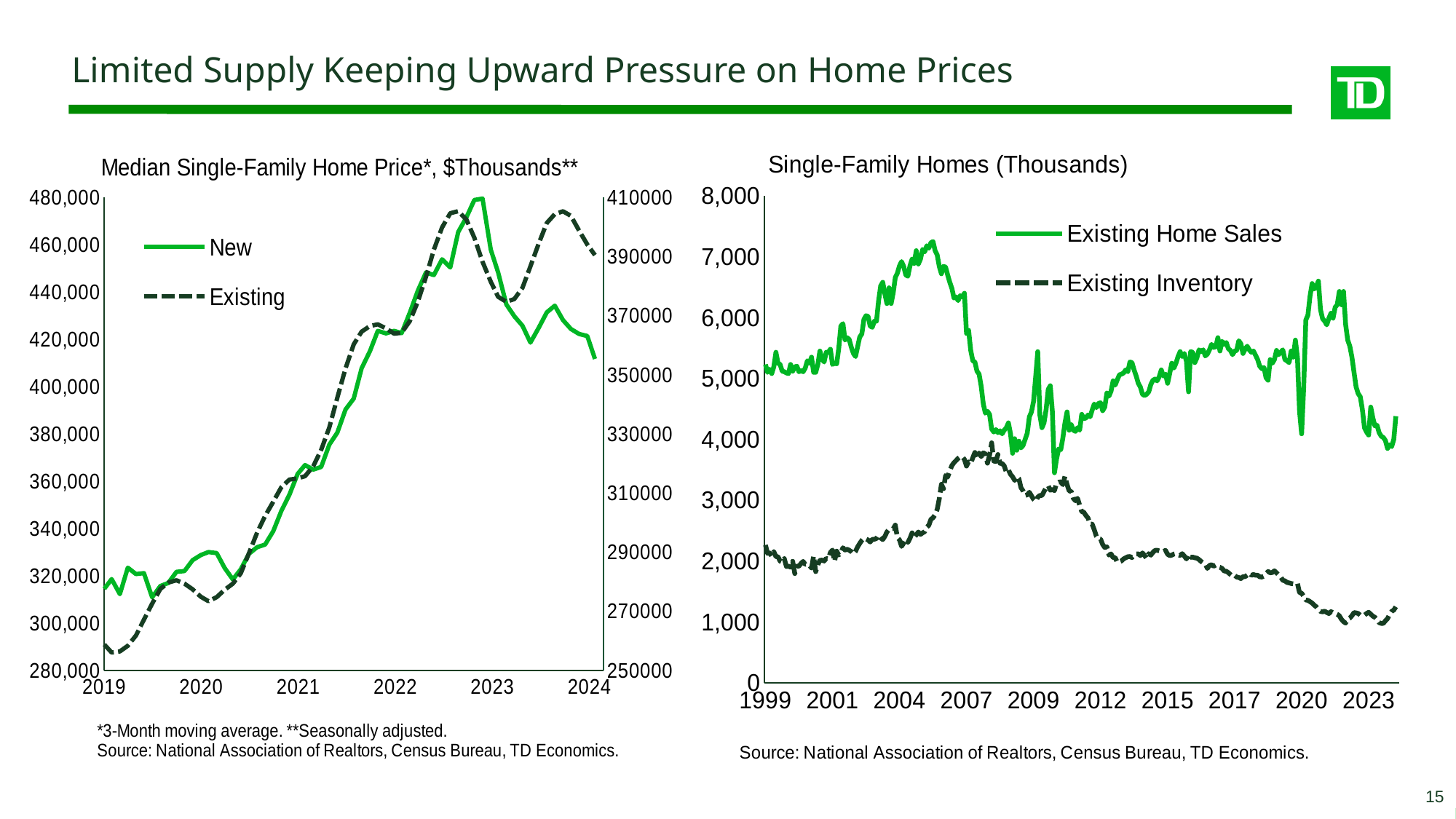
In the right chart, is the value of Existing Inventory in 2023 greater or less than 2,000? less In the right chart, in 2023, which series has the higher value: Existing Home Sales or Existing Inventory? Existing Home Sales What kind of chart is the right chart titled "Single-Family Homes (Thousands)"? line chart How many series does the legend of the left chart list? 2 In the left chart, which series is drawn with a dashed line? Existing In the right chart, is the peak value of Existing Home Sales around 2005 greater or less than 6,000? greater What kind of chart is the left chart titled "Median Single-Family Home Price*, $Thousands**"? line chart In the left chart, does the New series rise or fall between 2019 and 2022? rise How many series does the legend of the right chart list? 2 In the left chart, is the value of the New series at the start of 2019 greater or less than 300,000? greater In the right chart, which series is drawn with a dashed line? Existing Inventory